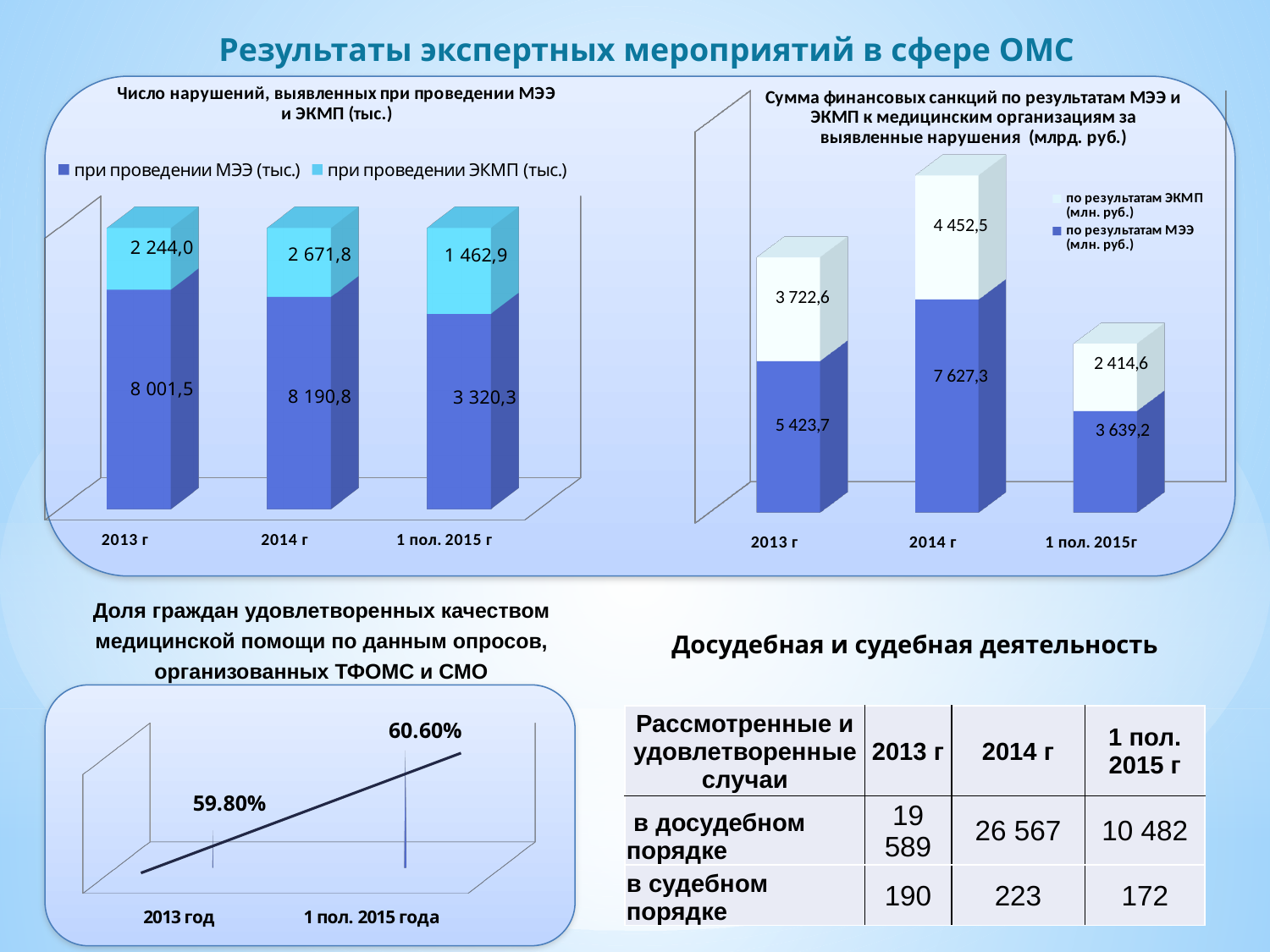
In the chart 'Число нарушений, выявленных при проведении МЭЭ и ЭКМП (тыс.)', what is the total of the stacked bar for 2013 г? 10 245,5 In the chart 'Число нарушений, выявленных при проведении МЭЭ и ЭКМП (тыс.)', which period has the highest value for 'при проведении ЭКМП (тыс.)'? 2014 г In the chart 'Число нарушений, выявленных при проведении МЭЭ и ЭКМП (тыс.)', what is the value for 'при проведении МЭЭ (тыс.)' in 2014 г? 8 190,8 What kind of chart is 'Доля граждан удовлетворенных качеством медицинской помощи по данным опросов, организованных ТФОМС и СМО'? line chart In the chart 'Число нарушений, выявленных при проведении МЭЭ и ЭКМП (тыс.)', what is the value for 'при проведении ЭКМП (тыс.)' in 1 пол. 2015 г? 1 462,9 In the chart 'Сумма финансовых санкций по результатам МЭЭ и ЭКМП', what is the value for 'по результатам ЭКМП (млн. руб.)' in 2014 г? 4 452,5 In the chart 'Сумма финансовых санкций по результатам МЭЭ и ЭКМП', what is the total of the stacked bar for 2014 г? 12 079,8 In the chart 'Число нарушений, выявленных при проведении МЭЭ и ЭКМП (тыс.)', what is the difference between the 'при проведении МЭЭ (тыс.)' values for 2014 г and 2013 г? 189,3 In the chart 'Сумма финансовых санкций по результатам МЭЭ и ЭКМП', what is the value for 'по результатам МЭЭ (млн. руб.)' in 1 пол. 2015г? 3 639,2 In the chart 'Доля граждан удовлетворенных качеством медицинской помощи', what is the value for 1 пол. 2015 года? 60.60% In the chart 'Сумма финансовых санкций по результатам МЭЭ и ЭКМП', how many series does the legend list? 2 In the chart 'Сумма финансовых санкций по результатам МЭЭ и ЭКМП', which period has the lowest value for 'по результатам МЭЭ (млн. руб.)'? 1 пол. 2015г